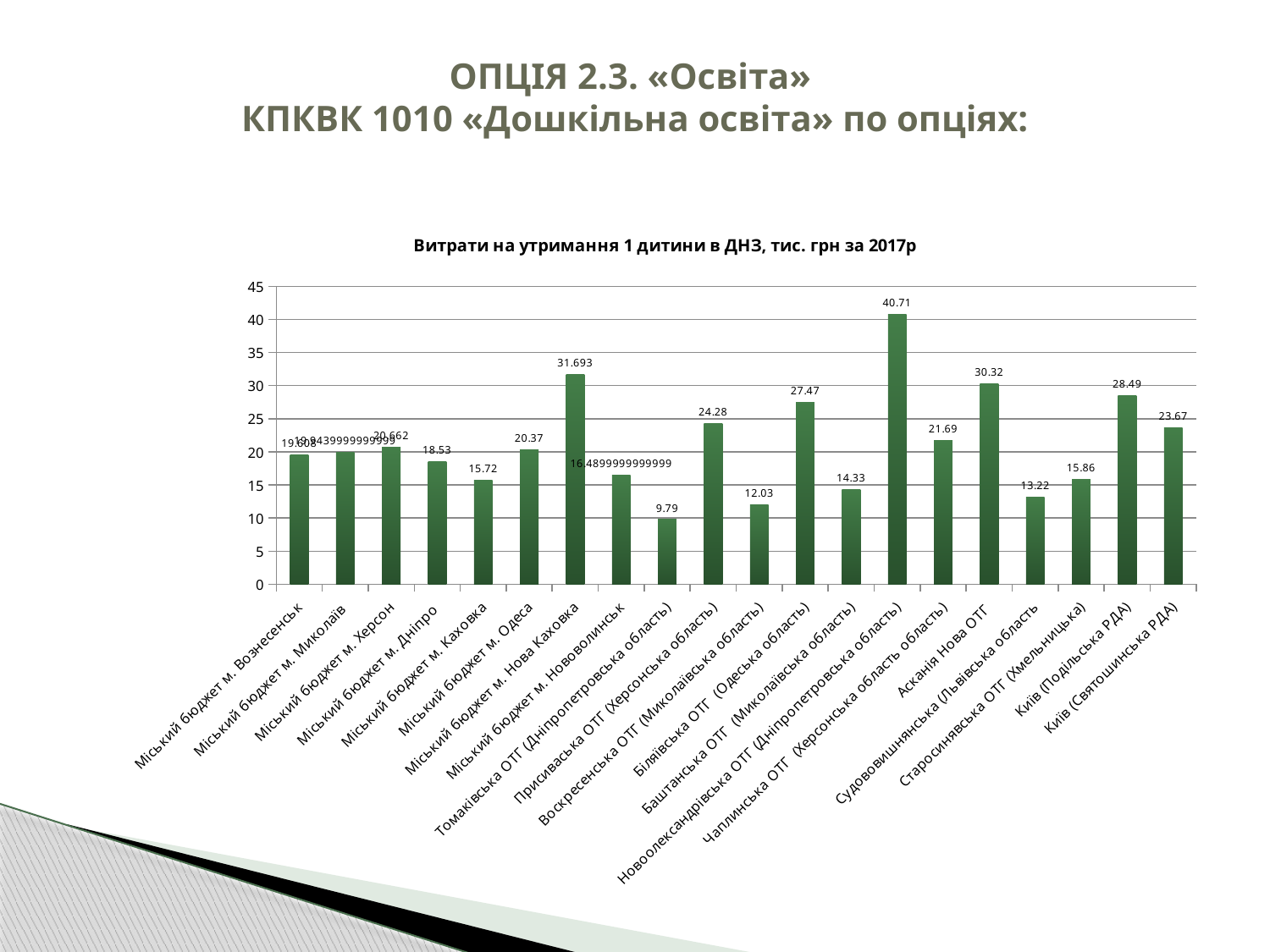
Is the value for Міський бюджет м. Дніпро greater or less than 20? less What is the value for Київ (Подільська РДА)? 28.49 What is the value for Томаківська ОТГ (Дніпропетровська область)? 9.79 Which is larger, the value for Присиваська ОТГ (Херсонська область) or the value for Київ (Святошинська РДА)? Присиваська ОТГ (Херсонська область) Which category has the lowest value? Томаківська ОТГ (Дніпропетровська область) What is the difference between the values for Асканія Нова ОТГ and Біляївська ОТГ (Одеська область)? 2.85 How many categories are shown on the x axis? 20 What is the title of the chart? Витрати на утримання 1 дитини в ДНЗ, тис. грн за 2017р What is the value for Міський бюджет м. Нова Каховка? 31.693 Which category has the highest value? Новоолександрівська ОТГ (Дніпропетровська область) What type of chart is shown on the slide? bar chart What is the value for Новоолександрівська ОТГ (Дніпропетровська область)? 40.71